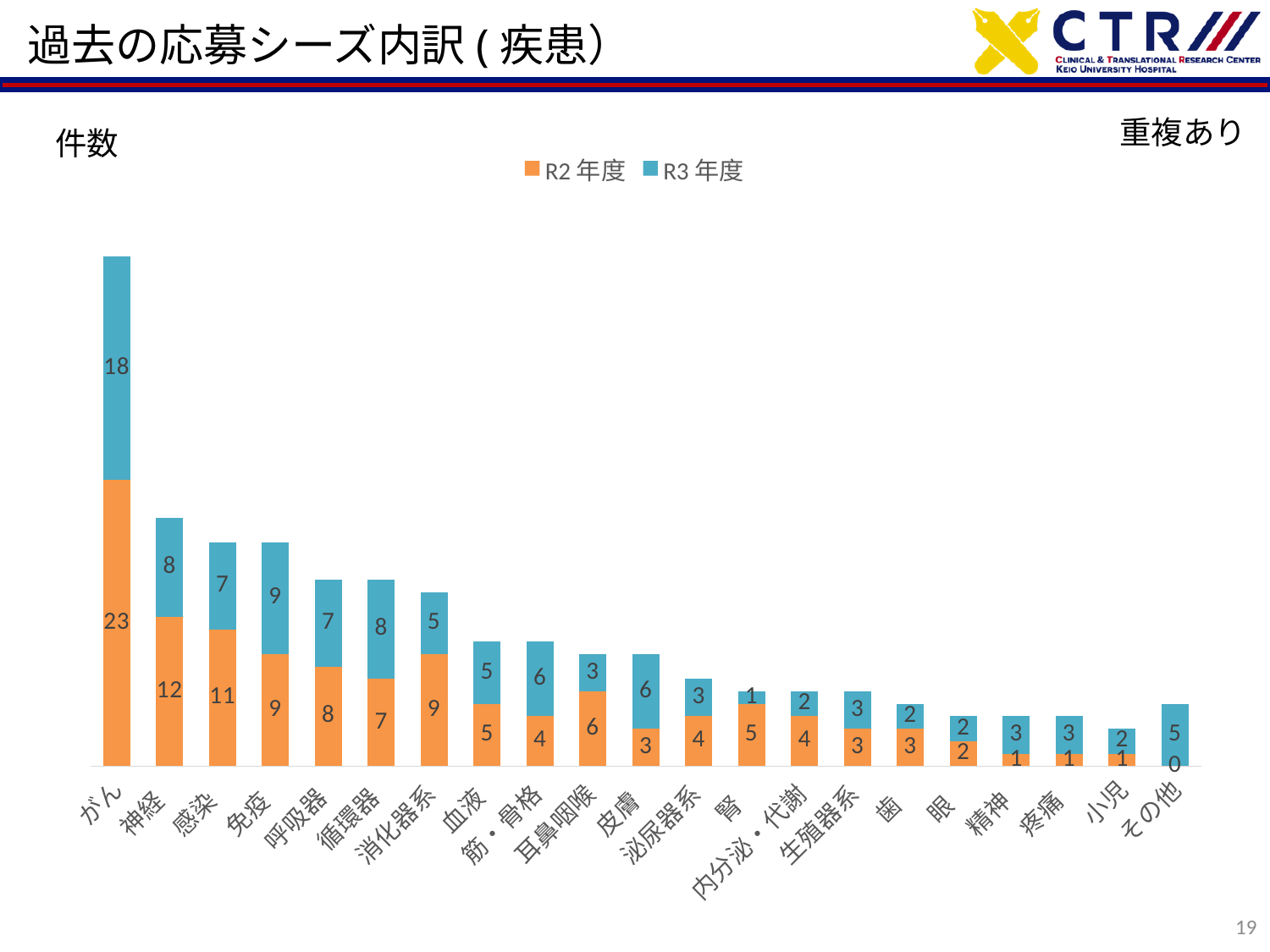
What is the difference between the R2年度 and R3年度 values for 消化器系? 4 Which category has the highest total stacked bar? がん What is the R2年度 value for その他? 0 What is the R2年度 value for がん? 23 What kind of chart is shown on the slide? Stacked bar chart How many series does the legend list? 2 What is the total of the stacked bar for がん? 41 What is the total of the stacked bar for 免疫? 18 What is the R3年度 value for 神経? 8 Which series is shown in orange in the legend? R2年度 Which is larger for 皮膚, the R2年度 value or the R3年度 value? R3年度 How many categories are shown on the x axis? 21